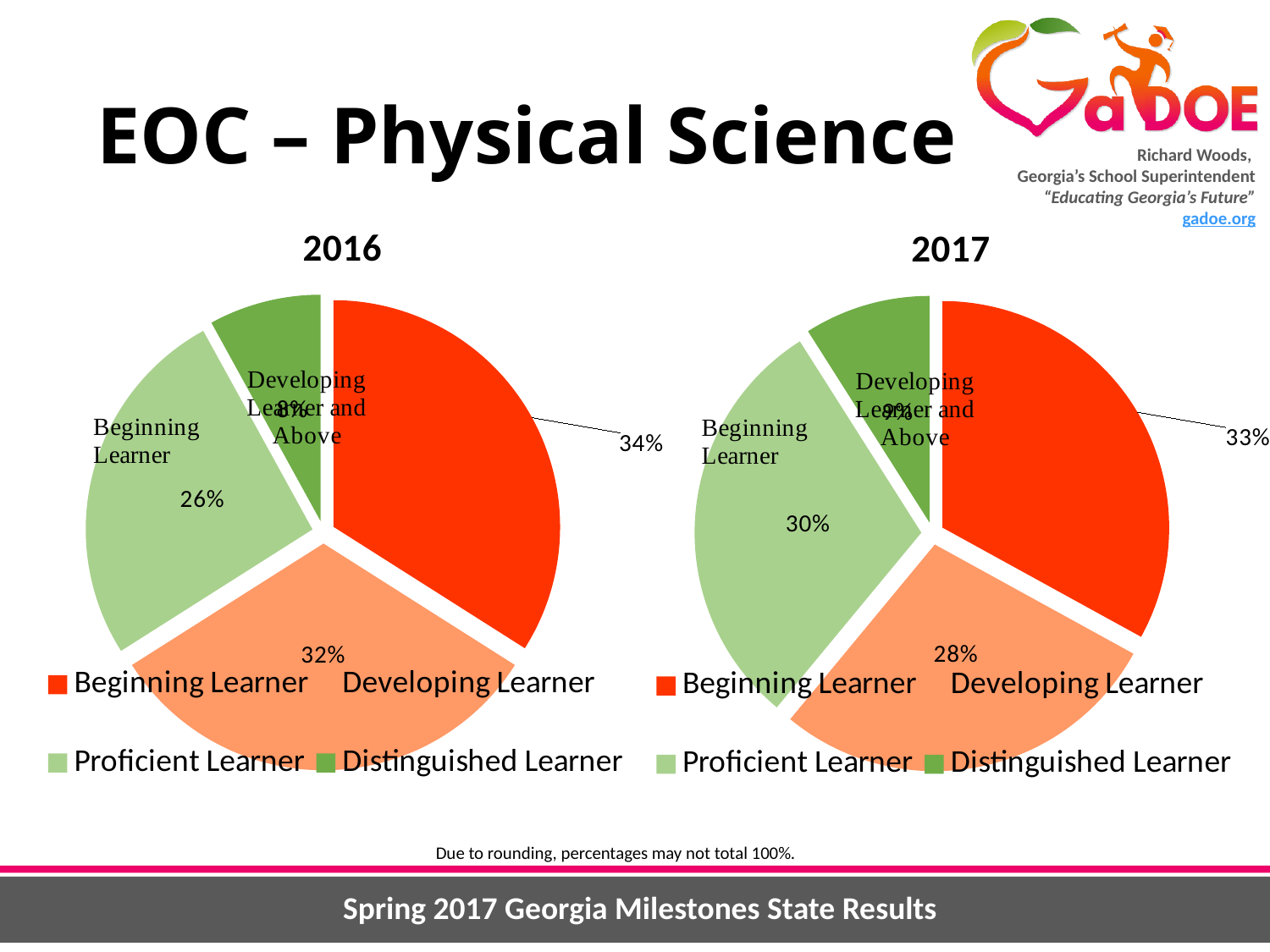
In the 2017 pie chart, what percentage is shown for Developing Learner? 28% In the 2017 pie chart, what percentage is shown for Proficient Learner? 30% In the 2016 pie chart, which category has the largest slice? Beginning Learner In the 2017 pie chart, which category has the smallest slice? Distinguished Learner How many entries does the legend of the 2016 chart list? 4 In the 2017 pie chart, what percentage is shown for Beginning Learner? 33% In the 2017 pie chart, which is larger: Proficient Learner or Developing Learner? Proficient Learner What type of chart is used to show the 2016 results? Pie chart In the 2016 pie chart, what percentage is shown for Beginning Learner? 34% In the 2016 pie chart, what percentage is shown for Developing Learner? 32% In the 2016 pie chart, what is the difference between the Beginning Learner and Proficient Learner percentages? 8 percentage points How many slices does the 2017 pie chart have? 4